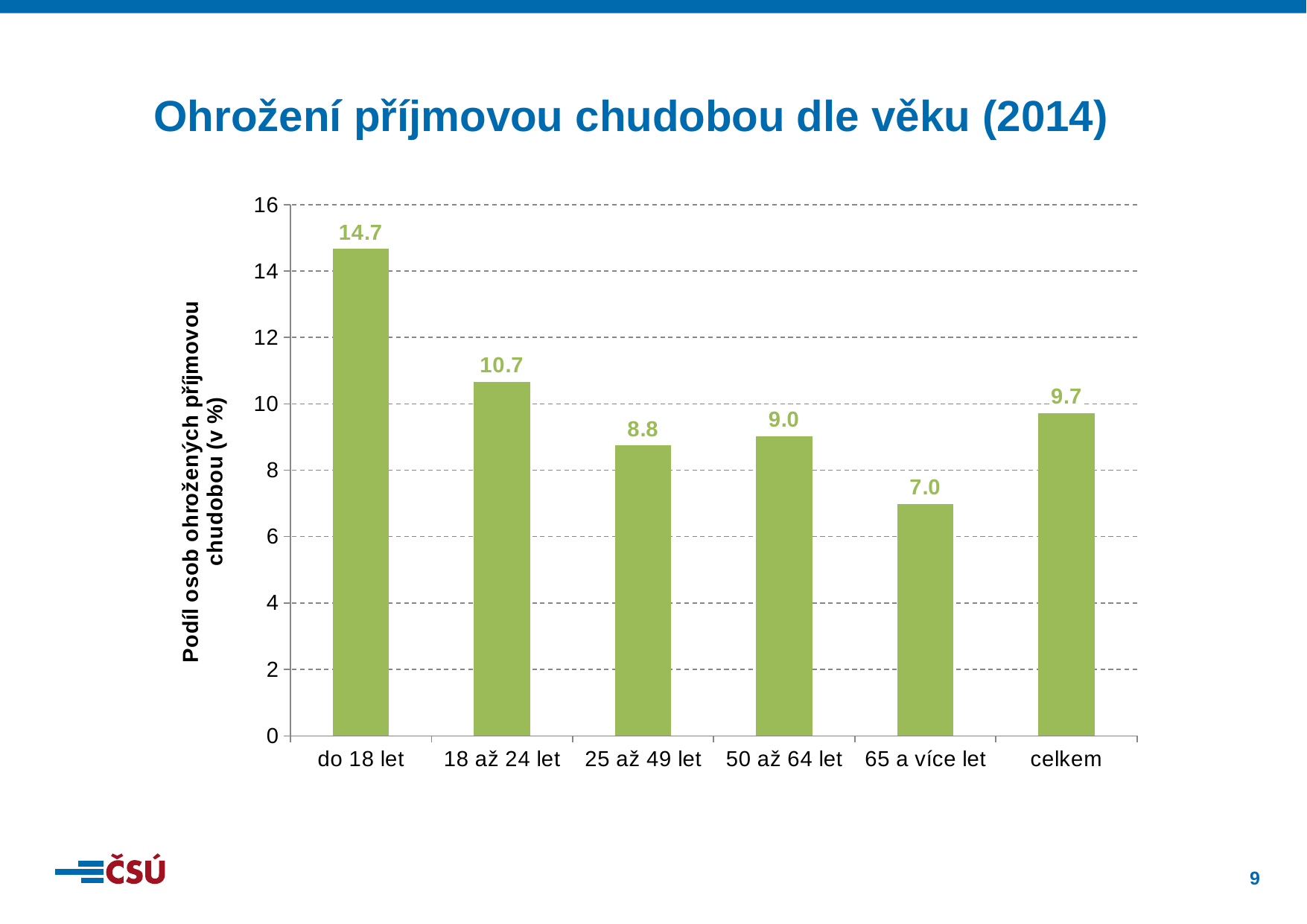
What is the value for the '65 a více let' category? 7.0 Which category has the lowest value? 65 a více let What is the difference between the values for 'do 18 let' and '18 až 24 let'? 4.0 What is the difference between the values for 'celkem' and '65 a více let'? 2.7 What is the value for the 'do 18 let' category? 14.7 What is the value for 'celkem'? 9.7 How many categories are shown on the x axis? 6 What is the title of the chart on the slide? Ohrožení příjmovou chudobou dle věku (2014) Which category has the highest value? do 18 let What kind of chart is shown on the slide? bar chart Which is larger, the value for '25 až 49 let' or '50 až 64 let'? 50 až 64 let Is the value for '18 až 24 let' greater or less than 10? greater